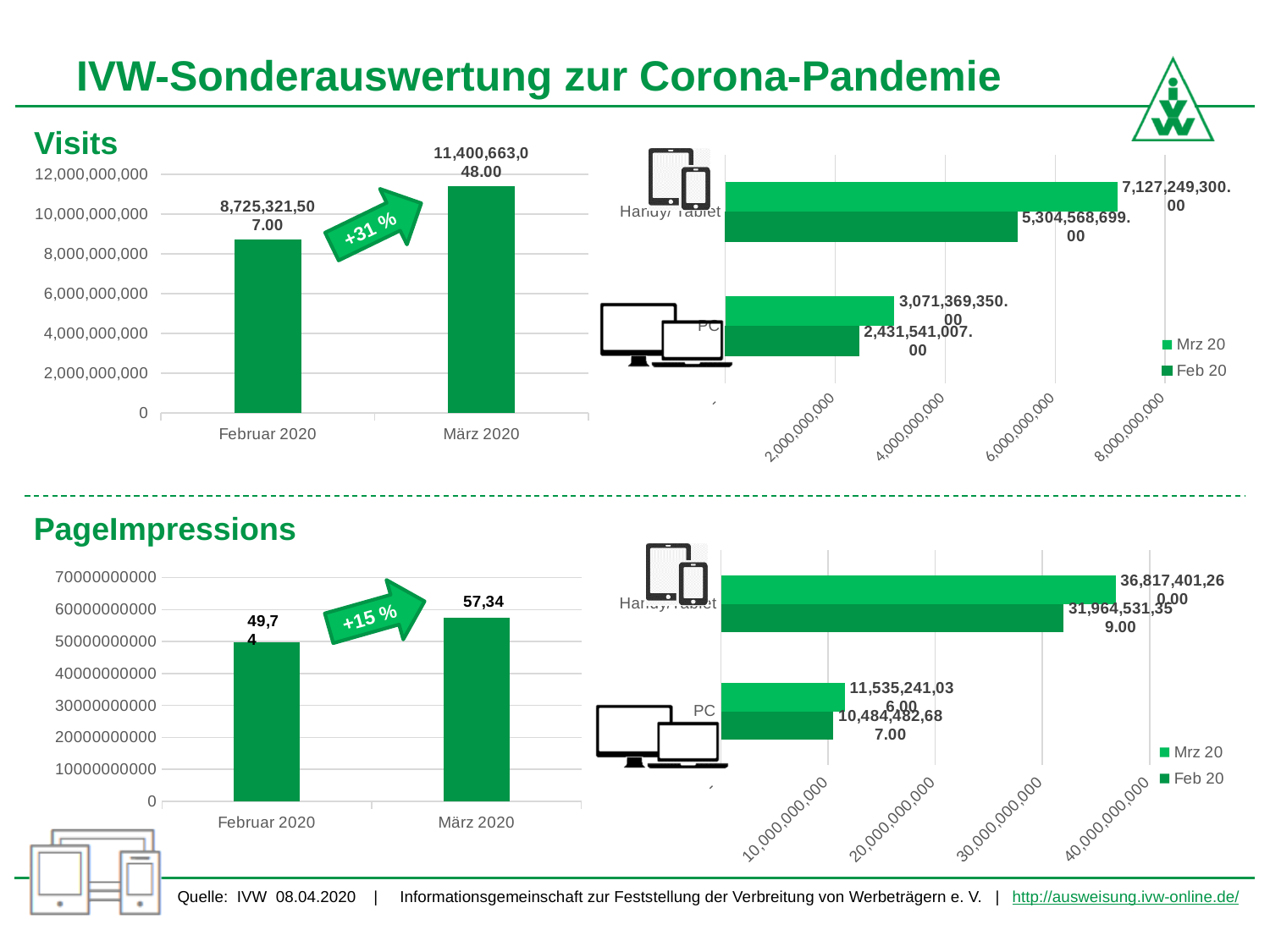
In the Visits bar chart on the left, do the values rise or fall from Februar 2020 to März 2020? rise In the Visits bar chart on the left, what is the value for Februar 2020? 8,725,321,507.00 In the PageImpressions bar chart on the bottom left, what is the value for März 2020? 57,34 In the Visits by device chart on the top right, which is larger: the Feb 20 value for Handy/Tablet or the Mrz 20 value for PC? Feb 20 value for Handy/Tablet In the Visits bar chart on the left, what percentage change is shown on the arrow between Februar 2020 and März 2020? +31 % In the PageImpressions by device chart on the bottom right, what is the Mrz 20 value for Handy/Tablet? 36,817,401,260.00 In the Visits bar chart on the left, what is the value for März 2020? 11,400,663,048.00 In the Visits by device chart on the top right, what is the Mrz 20 value for Handy/Tablet? 7,127,249,300.00 In the PageImpressions bar chart on the bottom left, what percentage change is shown on the arrow? +15 % In the Visits by device chart on the top right, how many series does the legend list? 2 In the Visits by device chart on the top right, what is the Feb 20 value for PC? 2,431,541,007.00 In the PageImpressions by device chart on the bottom right, what is the Feb 20 value for PC? 10,484,482,687.00